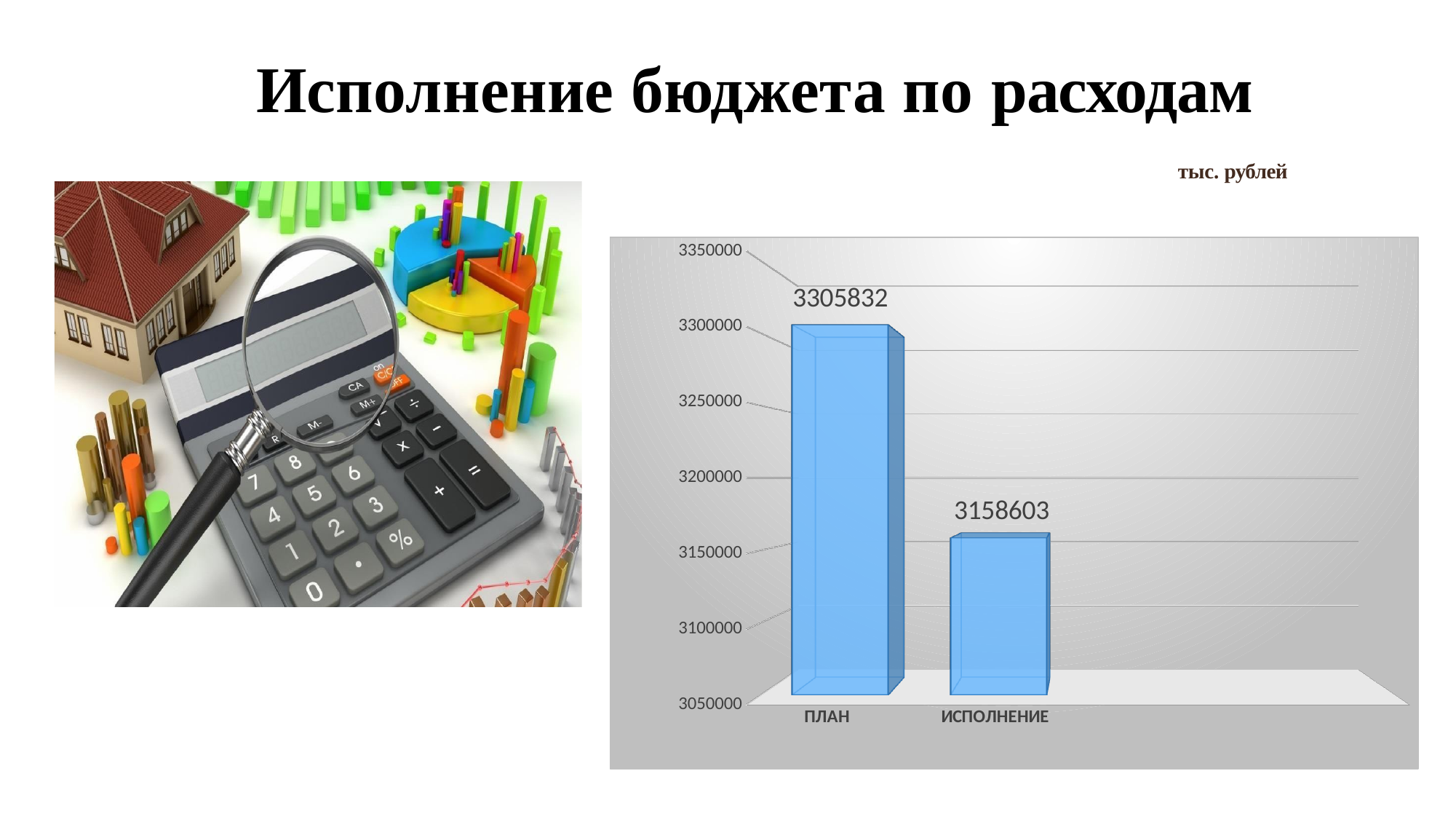
What kind of chart is shown on the slide? bar chart What is the value for ПЛАН? 3305832 What is the value for ИСПОЛНЕНИЕ? 3158603 Which category has the highest value? ПЛАН What is the title of the slide? Исполнение бюджета по расходам Which category has the lowest value? ИСПОЛНЕНИЕ Which is larger, the value for ПЛАН or the value for ИСПОЛНЕНИЕ? ПЛАН What is the difference between the values for ПЛАН and ИСПОЛНЕНИЕ? 147229 Is the value for ПЛАН greater or less than 3300000? greater Is the value for ИСПОЛНЕНИЕ greater or less than 3200000? less How many categories are shown in the chart? 2 What unit is stated above the chart? тыс. рублей